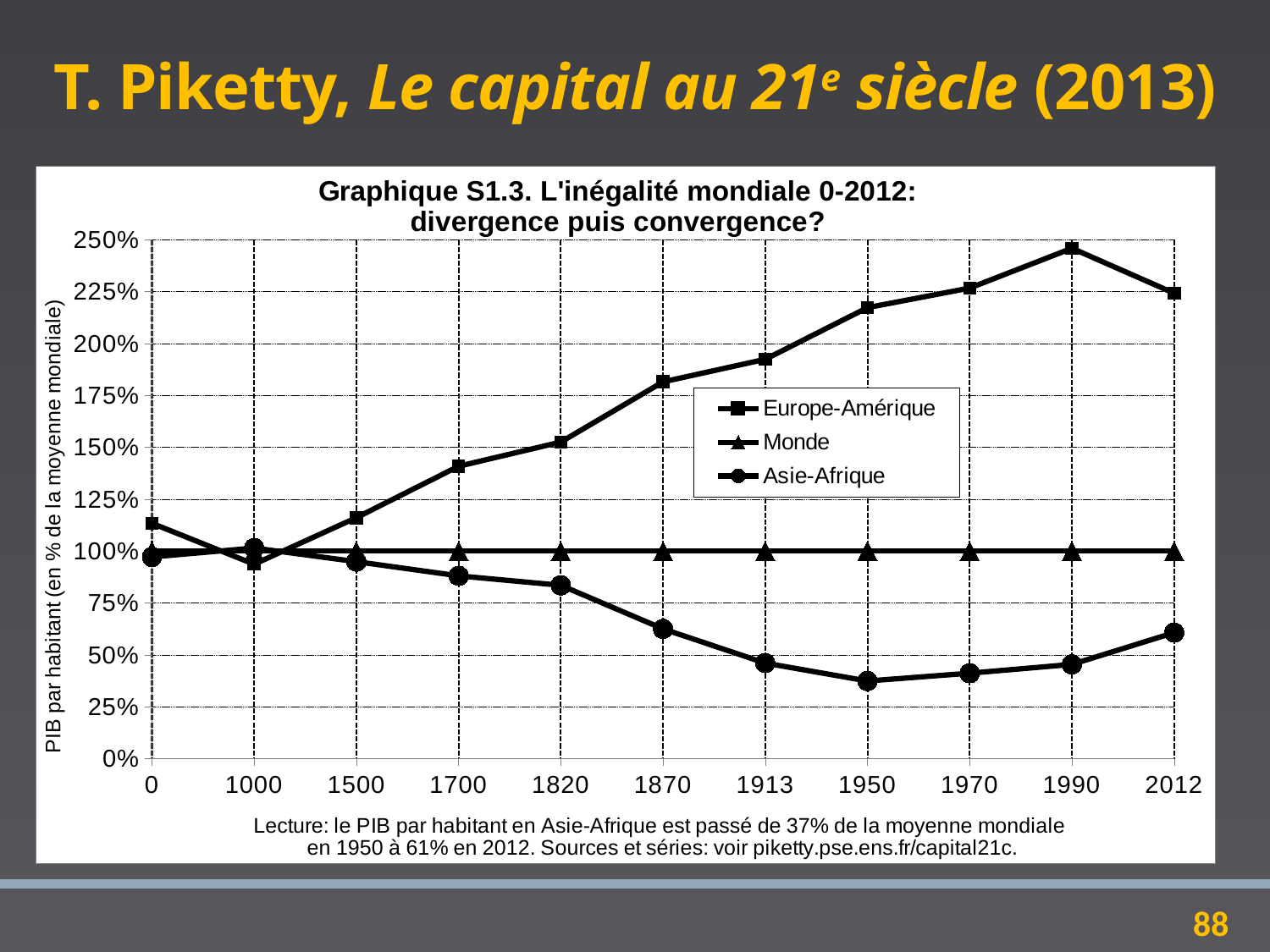
How many points are plotted along the x axis for each series? 11 What is the value of the Monde series in 1913? 100% Is the value for Europe-Amérique in 1990 greater or less than 225%? greater What kind of chart is shown on the slide? line chart Which series has the larger value in 2012, Europe-Amérique or Asie-Afrique? Europe-Amérique According to the note below the chart, what was the value for Asie-Afrique in 1950? 37% Is the value for Asie-Afrique in 1870 greater or less than 75%? less In which year does the Asie-Afrique series reach its lowest value? 1950 According to the note below the chart, what was the value for Asie-Afrique in 2012? 61% How many series does the legend list? 3 In which year does the Europe-Amérique series reach its highest value? 1990 By how many percentage points did the Asie-Afrique value change between 1950 and 2012? 24 percentage points